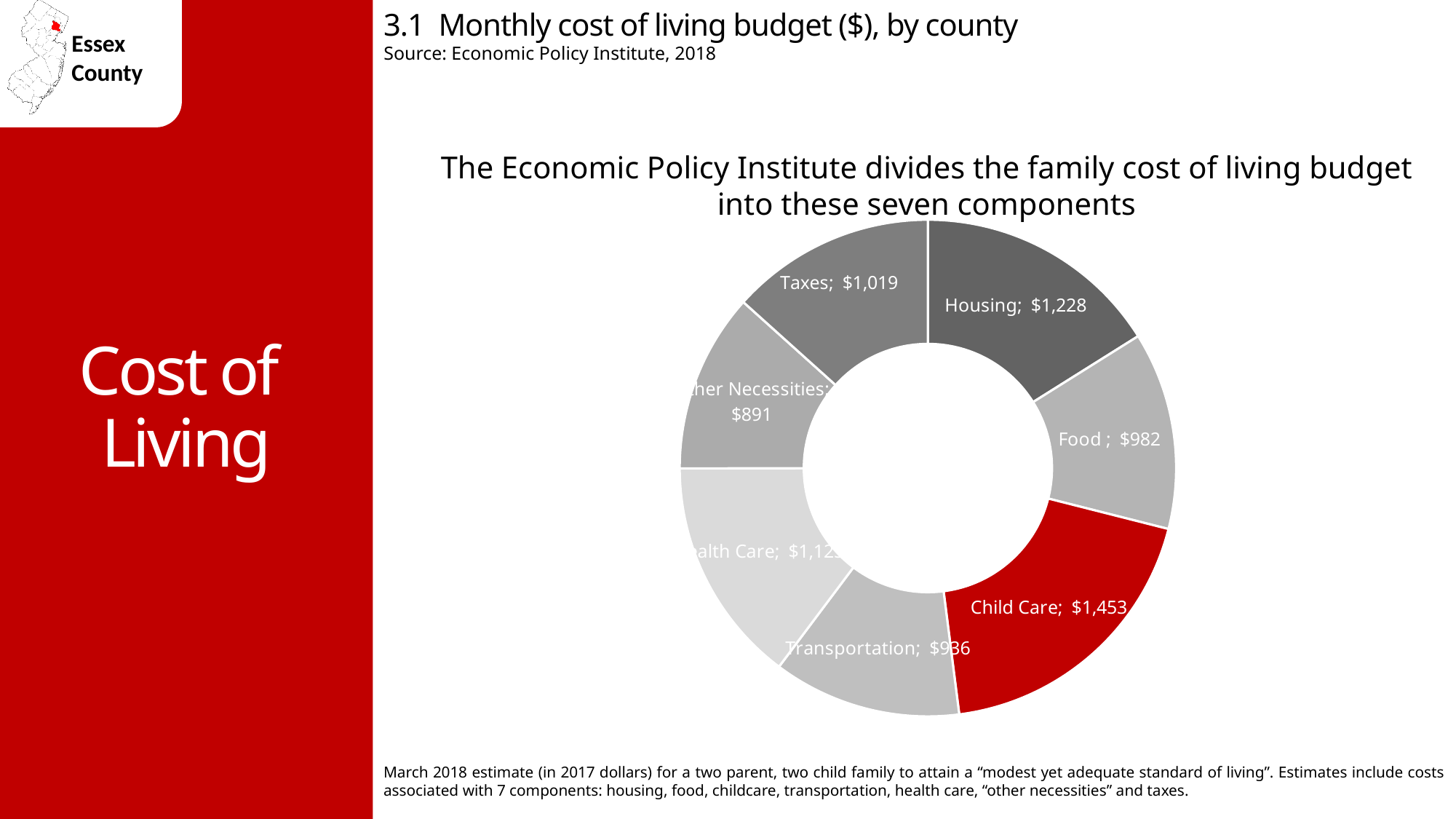
What is the monthly Taxes cost shown on the chart? $1,019 What kind of chart is shown on the slide? Doughnut chart What is the monthly Other Necessities cost shown on the chart? $891 Which component has the largest monthly cost? Child Care What is the monthly Child Care cost shown on the chart? $1,453 Which component is shown in red on the chart? Child Care How many components does the chart divide the cost of living budget into? 7 Which is larger, the Housing cost or the Food cost? Housing What is the monthly Housing cost shown on the chart? $1,228 What is the monthly Food cost shown on the chart? $982 What is the difference between the Housing and Food monthly costs? $246 What is the difference between the Child Care and Housing monthly costs? $225